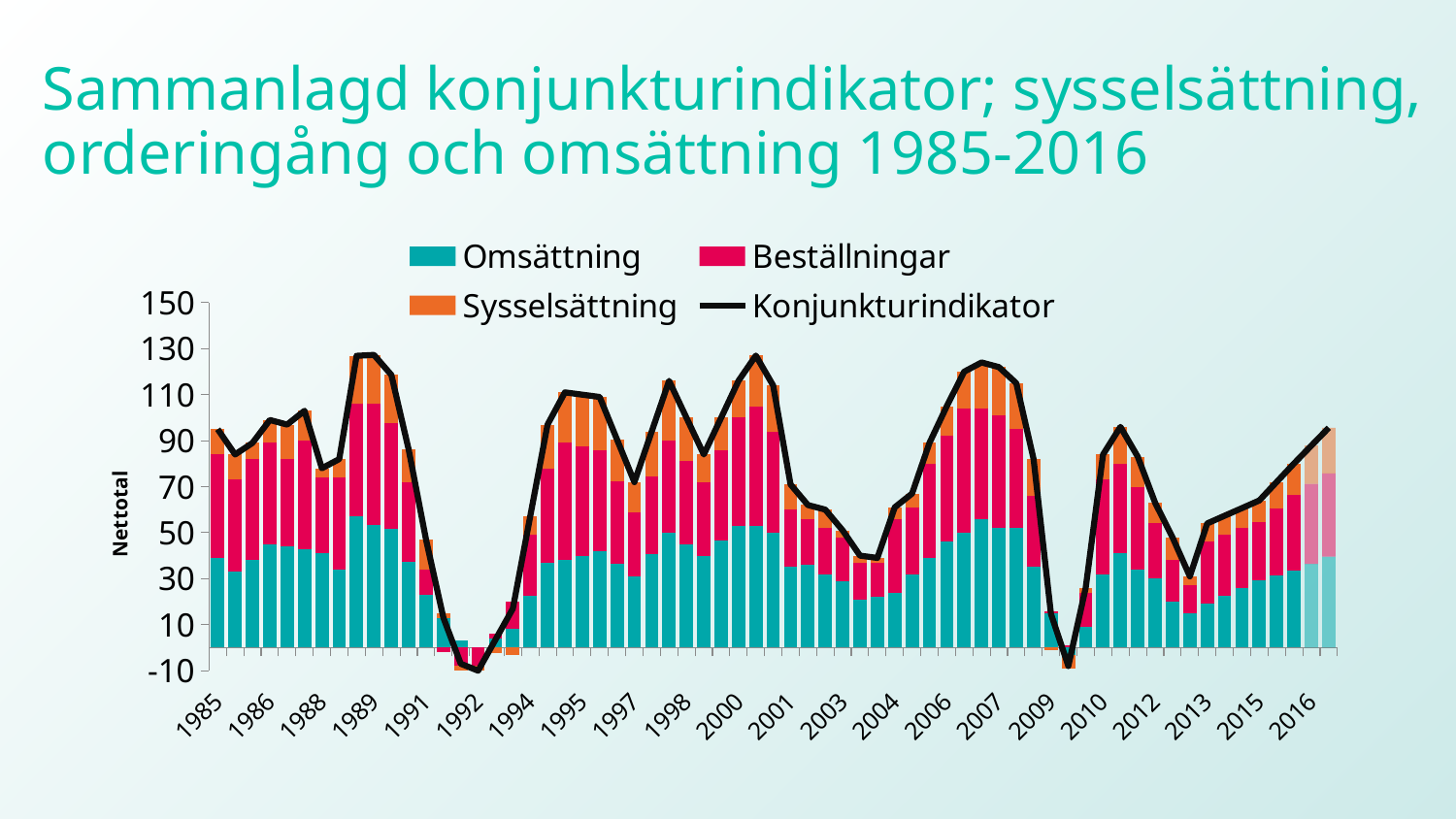
Does the Konjunkturindikator line rise or fall between 2013 and 2016? rise Which year has the higher Konjunkturindikator value, 2007 or 2013? 2007 What is the label on the vertical axis? Nettotal In which labelled year is the Konjunkturindikator line at its lowest? 1992 Which series is drawn as a black line? Konjunkturindikator Is the Konjunkturindikator value for 2016 greater or less than 70? greater Is the Konjunkturindikator value for 1989 greater or less than 110? greater Is the Konjunkturindikator value for 2007 greater or less than 110? greater How many series does the legend list? 4 What kind of chart is shown on the slide? A stacked bar chart with a line overlay